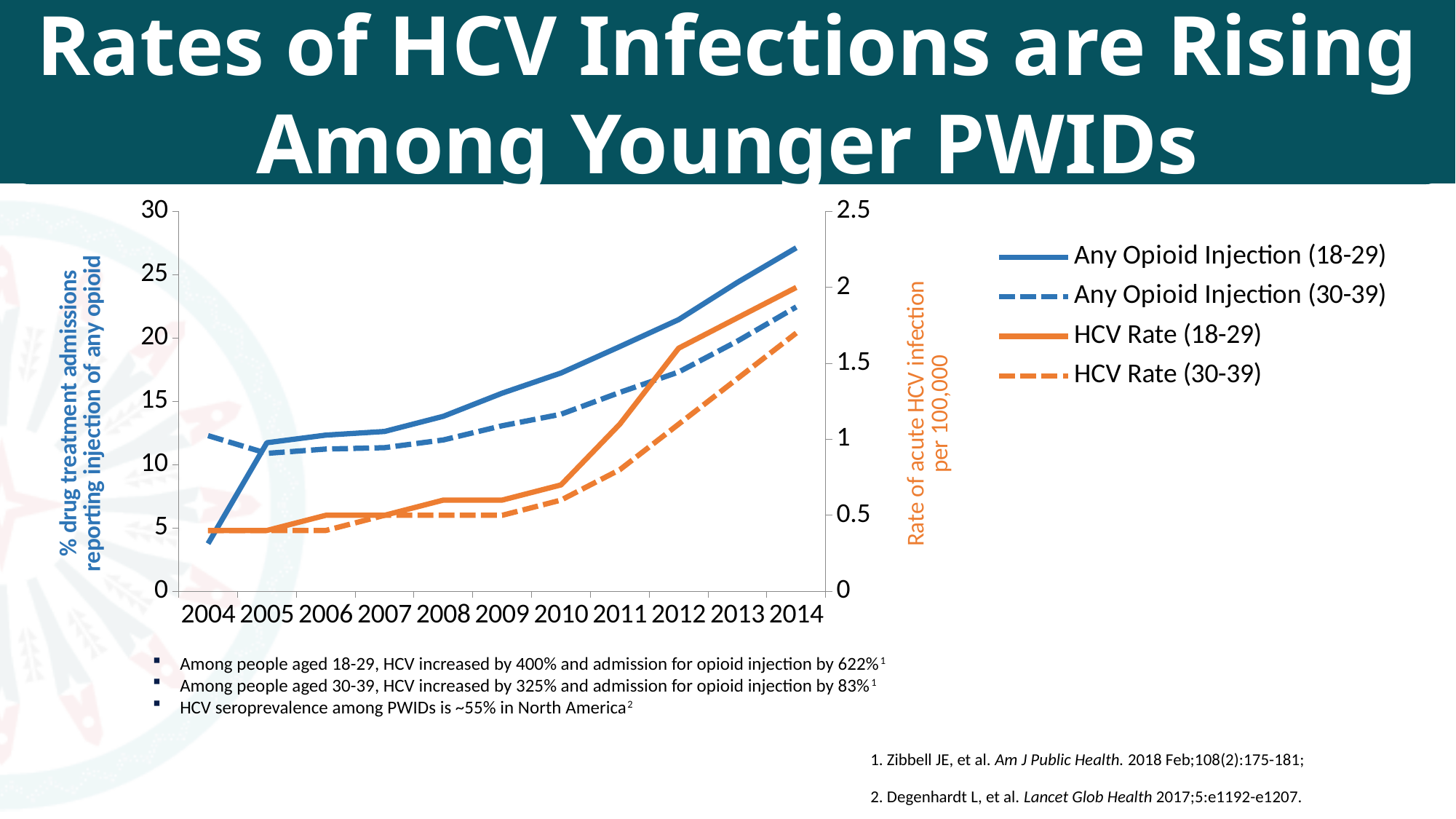
What is the label of the right-hand y axis of the chart? Rate of acute HCV infection per 100,000 Is the value for Any Opioid Injection (18-29) in 2014 greater or less than 25? greater How many series does the chart's legend list? 4 How many years are shown along the x axis of the chart? 11 In which year is the HCV Rate (18-29) series at its highest? 2014 What kind of chart is shown on the slide? Line chart In 2004, which is higher: Any Opioid Injection (18-29) or Any Opioid Injection (30-39)? Any Opioid Injection (30-39) Is the value for HCV Rate (30-39) in 2008 greater or less than 1? less Does the Any Opioid Injection (18-29) line rise or fall from 2004 to 2014? Rise In 2014, which is higher: Any Opioid Injection (18-29) or Any Opioid Injection (30-39)? Any Opioid Injection (18-29) Is the value for HCV Rate (18-29) in 2014 greater or less than 1.5? greater